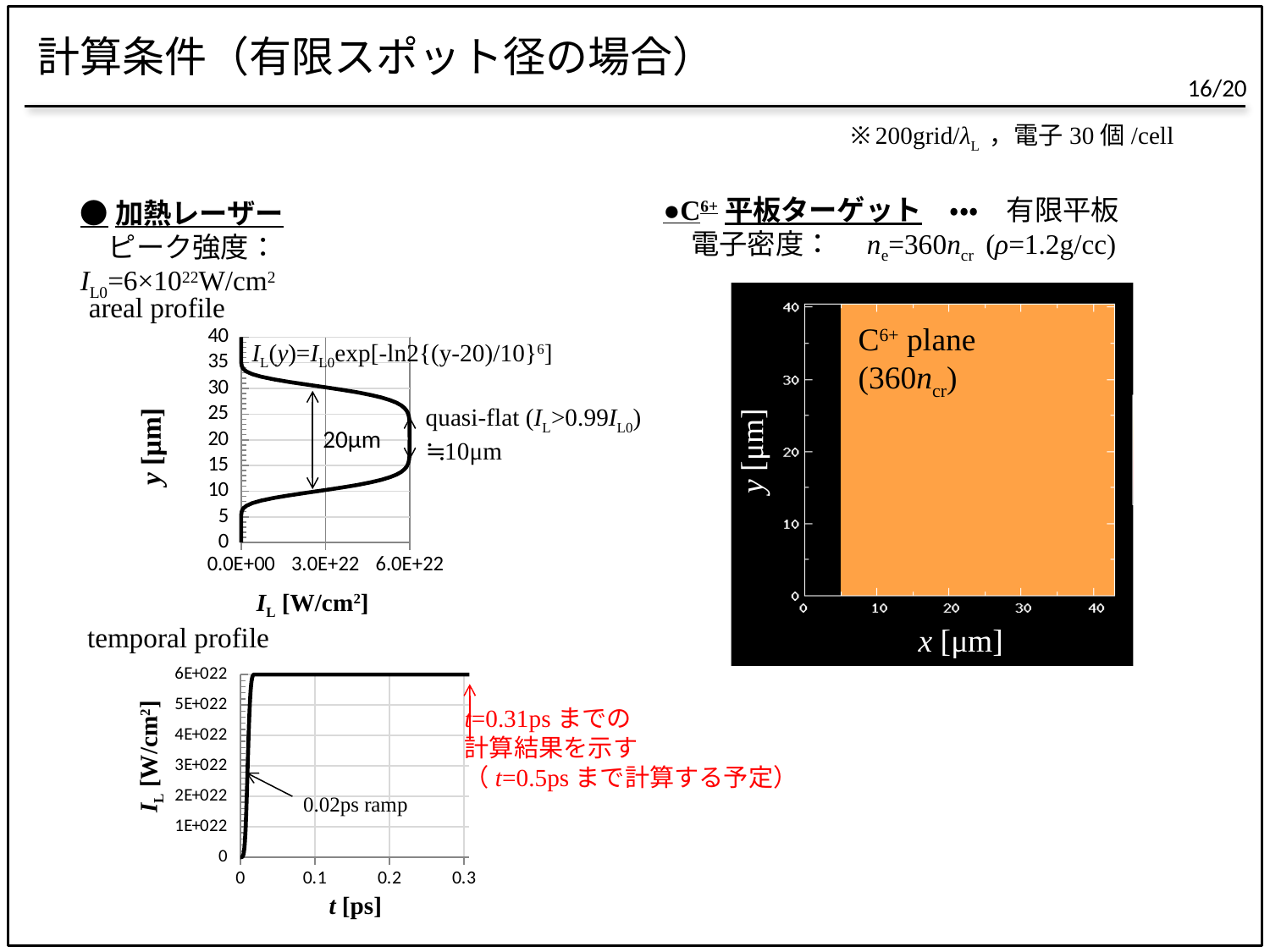
In the areal profile chart, what width is given for the quasi-flat region where I_L>0.99I_L0? ≒10µm What is the x-axis label of the temporal profile chart? t [ps] What kind of chart is the temporal profile chart at the bottom left? line chart In the target plot on the right, what label is written on the orange region? C6+ plane (360n_cr) In the temporal profile chart, what value does the intensity plateau at after the ramp? 6E+022 In the areal profile chart, is the intensity at y=0 µm greater or less than 3.0E+22? less In the temporal profile chart, what ramp duration is annotated on the rising edge? 0.02ps In the areal profile chart, is the intensity at y=20 µm greater or less than 3.0E+22? greater In the areal profile chart, what is the highest tick value on the y axis? 40 What kind of chart is the areal profile chart on the left? line chart In the areal profile chart, what width is annotated by the double arrow across the flat-top region? 20µm In the temporal profile chart, does the intensity rise or fall between t=0 and t=0.02 ps? rise